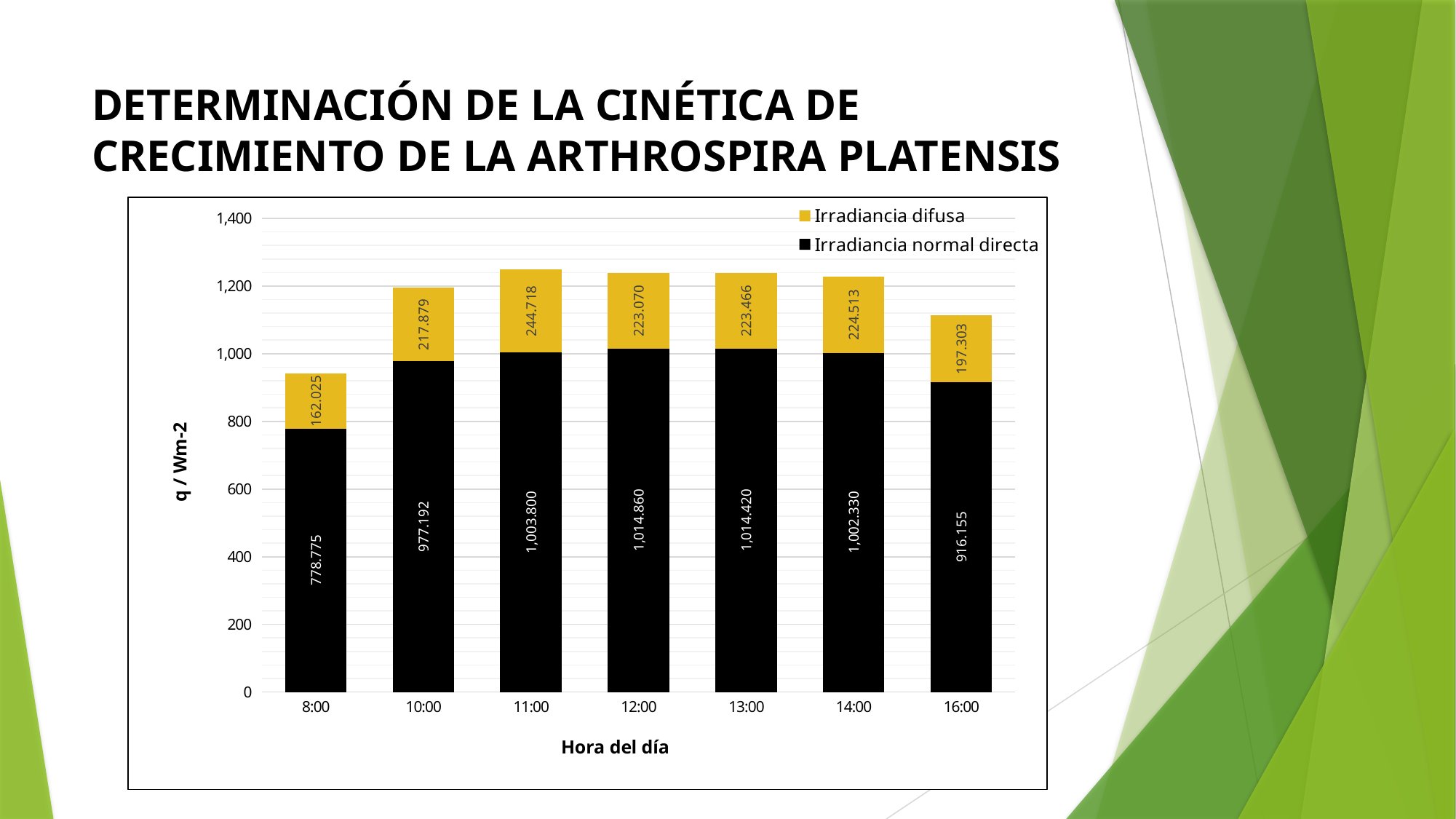
What is the total of the stacked bar at 8:00? 940.800 Is the total of the stacked bar at 8:00 greater or less than 1,000? less At which hour is Irradiancia difusa highest? 11:00 How many series does the legend list? 2 What type of chart is shown on the slide? stacked bar chart At which hour is Irradiancia normal directa lowest? 8:00 What is the difference between Irradiancia difusa at 11:00 and at 8:00? 82.693 What is the value of Irradiancia normal directa at 8:00? 778.775 Which is larger: Irradiancia normal directa at 10:00 or at 16:00? 10:00 How many time categories are shown on the x axis? 7 What is the value of Irradiancia normal directa at 16:00? 916.155 What is the value of Irradiancia difusa at 11:00? 244.718